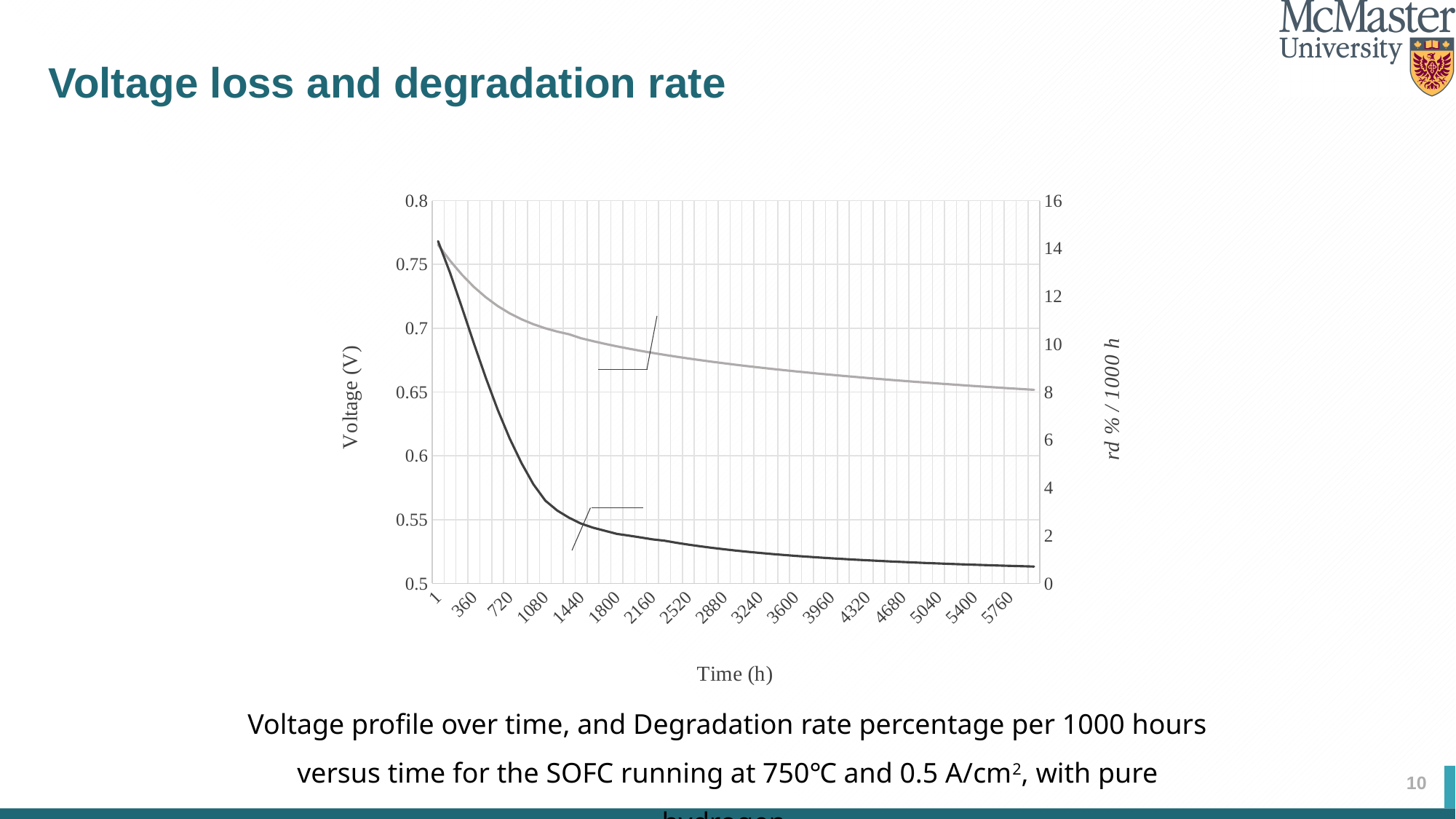
Does the dark line (voltage) rise or fall as time increases along the x axis? Fall Is the voltage (dark line) at time 1 h greater or less than 0.75 V? greater Is the degradation rate (grey line) at 2880 h greater or less than 10 %/1000 h? less What is the label of the left vertical axis? Voltage (V) What is the label of the horizontal axis? Time (h) What kind of chart is shown on the slide? Line chart How many tick labels are shown on the Time (h) axis? 17 How many lines are plotted on the chart? 2 Is the voltage (dark line) at 720 h greater or less than 0.6 V? greater Does the grey line (degradation rate) rise or fall as time increases along the x axis? Fall